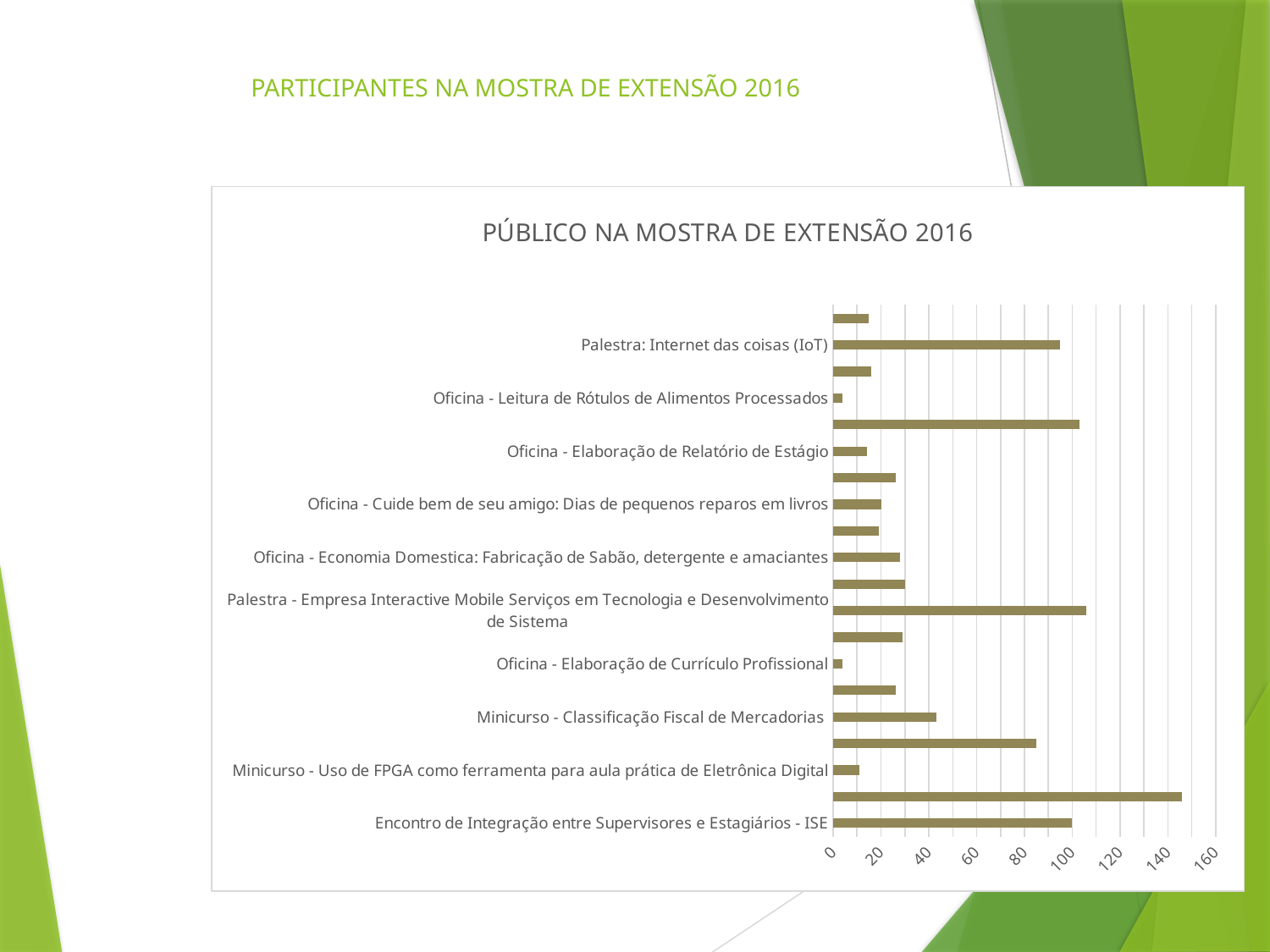
Is the value for Palestra - Empresa Interactive Mobile Serviços em Tecnologia e Desenvolvimento de Sistema greater or less than 80? greater What is the title of the chart? PÚBLICO NA MOSTRA DE EXTENSÃO 2016 Which has a larger value: Minicurso - Classificação Fiscal de Mercadorias or Oficina - Elaboração de Relatório de Estágio? Minicurso - Classificação Fiscal de Mercadorias Is the value for Oficina - Cuide bem de seu amigo: Dias de pequenos reparos em livros greater or less than 40? less Which has a larger value: Encontro de Integração entre Supervisores e Estagiários - ISE or Oficina - Elaboração de Currículo Profissional? Encontro de Integração entre Supervisores e Estagiários - ISE Is the value for Encontro de Integração entre Supervisores e Estagiários - ISE greater or less than 80? greater Which has a larger value: Palestra: Internet das coisas (IoT) or Minicurso - Uso de FPGA como ferramenta para aula prática de Eletrônica Digital? Palestra: Internet das coisas (IoT) What kind of chart is shown on the slide? bar chart What is the highest tick value shown on the value axis of the chart? 160